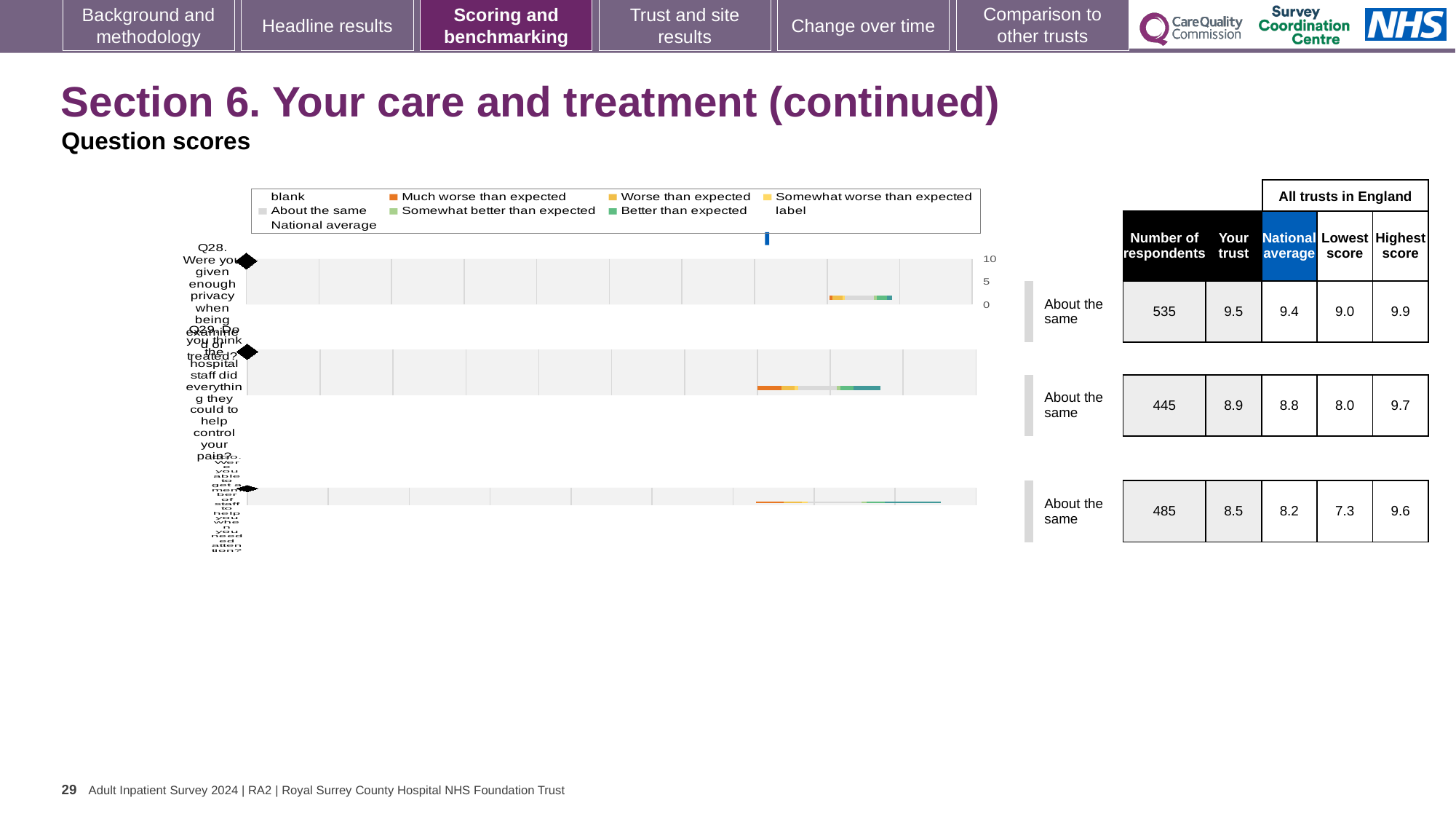
For Q29 (hospital staff helping control your pain), how many respondents are there? 445 Which question has the highest 'Your trust' score? Q28 For Q28 (privacy when being examined or treated), what is the 'Your trust' score? 9.5 For the third chart (Q30), what is the lowest score among all trusts in England? 7.3 For Q30, what is the difference between the 'Your trust' score and the national average? 0.3 For Q28, what is the national average score? 9.4 What benchmark category is shown for all three questions on this slide? About the same Which question has the lowest 'Your trust' score? Q30 How many questions (charts) are plotted on the slide? 3 For Q29, which is larger: the 'Your trust' score or the national average? Your trust What kind of chart is used to show the question scores on this slide? bar chart For Q29, what is the highest score among all trusts in England? 9.7